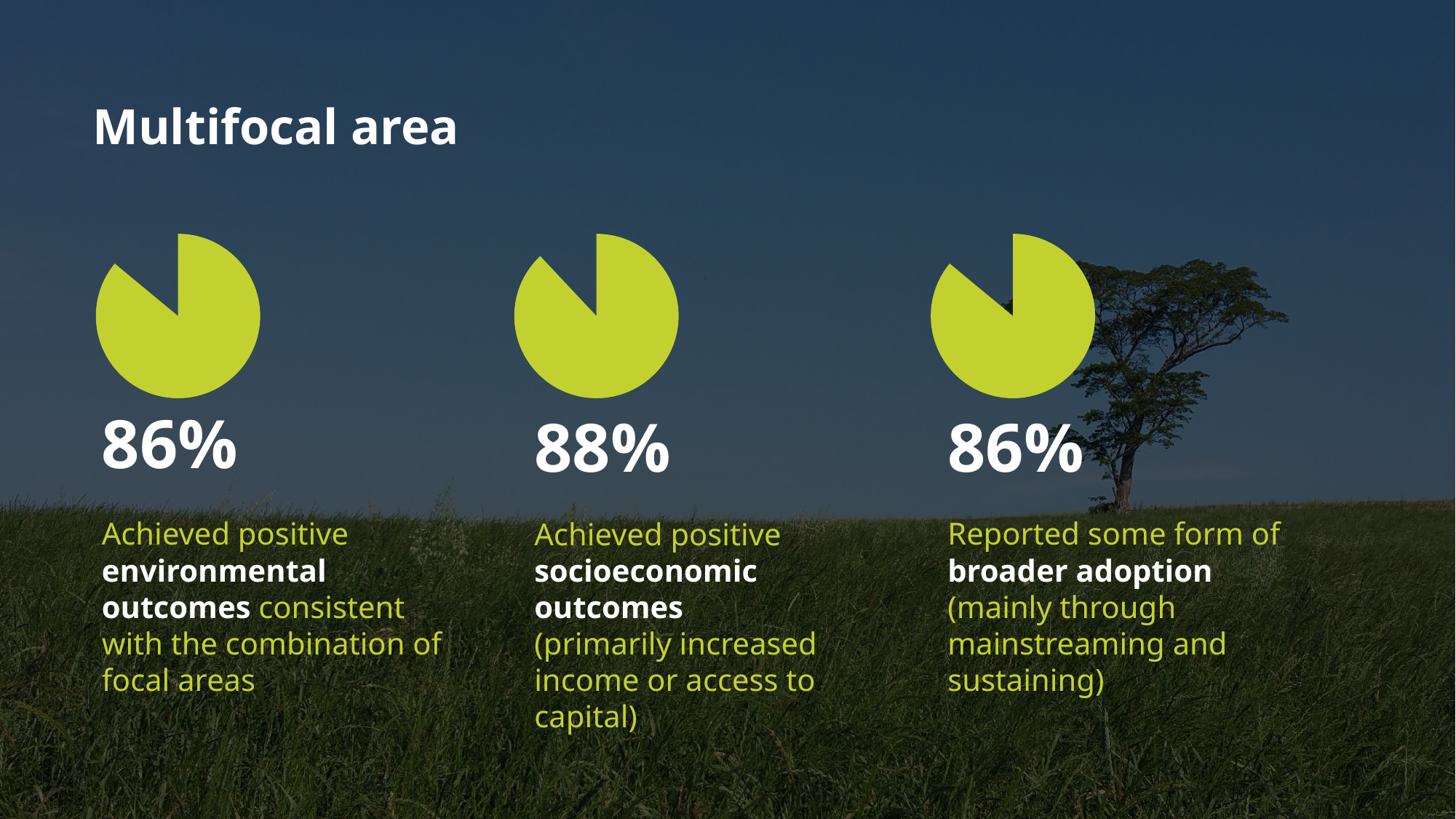
What percentage is shown for the middle pie chart, for positive socioeconomic outcomes? 88% Which is larger: the percentage for environmental outcomes or the percentage for socioeconomic outcomes? Socioeconomic outcomes What percentage is shown for the right pie chart, for broader adoption? 86% Which of the three outcomes has the highest percentage? Positive socioeconomic outcomes (88%) How many pie charts are on the slide? 3 What share of the middle pie chart is filled in? 88% What colour are the filled slices of the pie charts? Yellow-green Are the percentages for environmental outcomes and broader adoption the same? Yes, both 86% What is the difference between the socioeconomic outcomes percentage and the environmental outcomes percentage? 2 percentage points What percentage is shown for the left pie chart, for positive environmental outcomes? 86% What is the title of the slide containing the pie charts? Multifocal area What kind of chart is used to show the three percentages on the slide? Pie chart